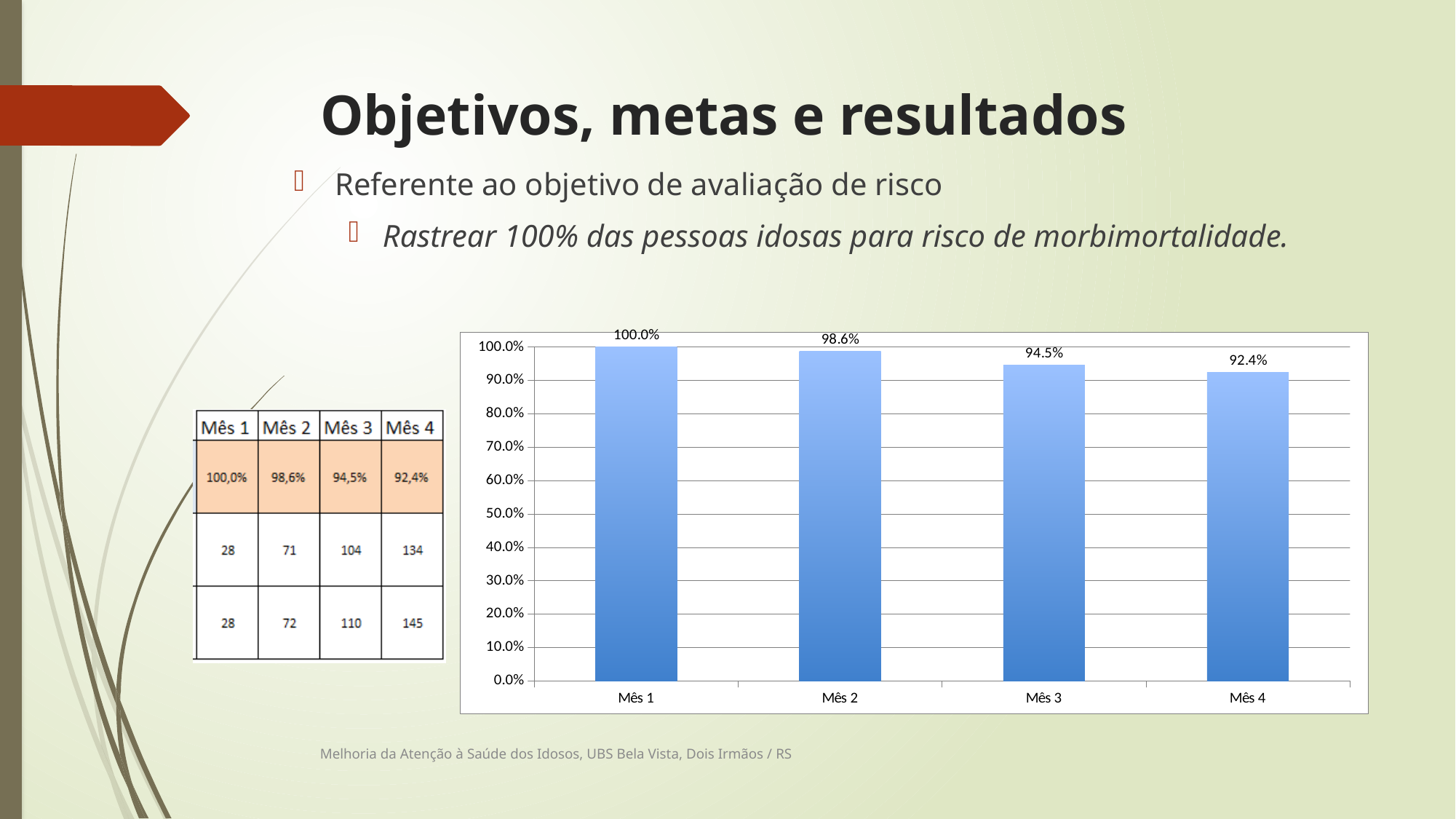
How many categories are shown on the x axis of the chart? 4 Which month has the highest value? Mês 1 What is the value for Mês 1? 100.0% Which is larger, the value for Mês 2 or the value for Mês 3? Mês 2 What is the difference between the values for Mês 1 and Mês 4? 7.6% What is the value for Mês 2? 98.6% Do the values rise or fall from Mês 1 to Mês 4? Fall What is the value for Mês 3? 94.5% Which month has the lowest value? Mês 4 What is the value for Mês 4? 92.4% What kind of chart is shown on the slide? Bar chart What is the difference between the values for Mês 2 and Mês 3? 4.1%